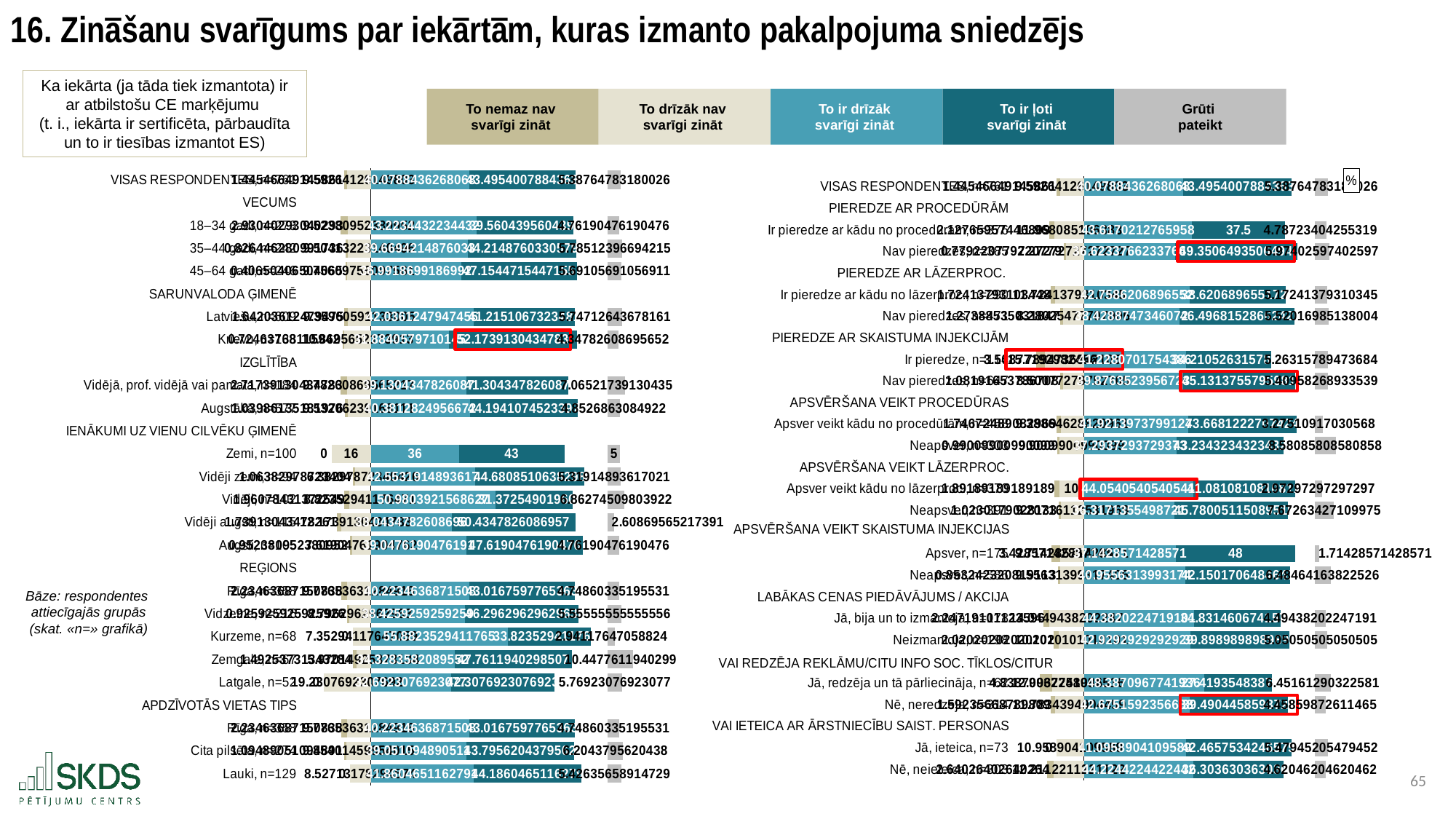
In the left chart, what is the value of 'To ir drīzāk svarīgi zināt' for the row 'Zemi, n=100'? 36 In the left chart, for the row 'Zemi, n=100', which is larger: 'To ir drīzāk svarīgi zināt' or 'To ir ļoti svarīgi zināt'? To ir ļoti svarīgi zināt How many series does the legend list? 5 In the right chart, what is the value of 'To drīzāk nav svarīgi zināt' for the row 'Apsver veikt kādu no lāzerproc.'? 10 In the right chart, what is the value of 'To ir ļoti svarīgi zināt' for the row 'Ir pieredze ar kādu no procedūrām'? 37.5 In the left chart, what is the value of 'To ir ļoti svarīgi zināt' for the row 'Zemi, n=100'? 43 In the left chart, what is the value of 'To nemaz nav svarīgi zināt' for the row 'Zemi, n=100'? 0 What is the label of the last (grey) legend entry? Grūti pateikt In the right chart, what is the value of 'To ir ļoti svarīgi zināt' for the row 'Apsver, n=175'? 48 In the left chart, what is the total of the stacked bar for 'Zemi, n=100'? 100 What kind of chart is shown on the slide? Stacked bar chart In the left chart, for the row 'Zemi, n=100', what is the difference between 'To ir ļoti svarīgi zināt' and 'To ir drīzāk svarīgi zināt'? 7